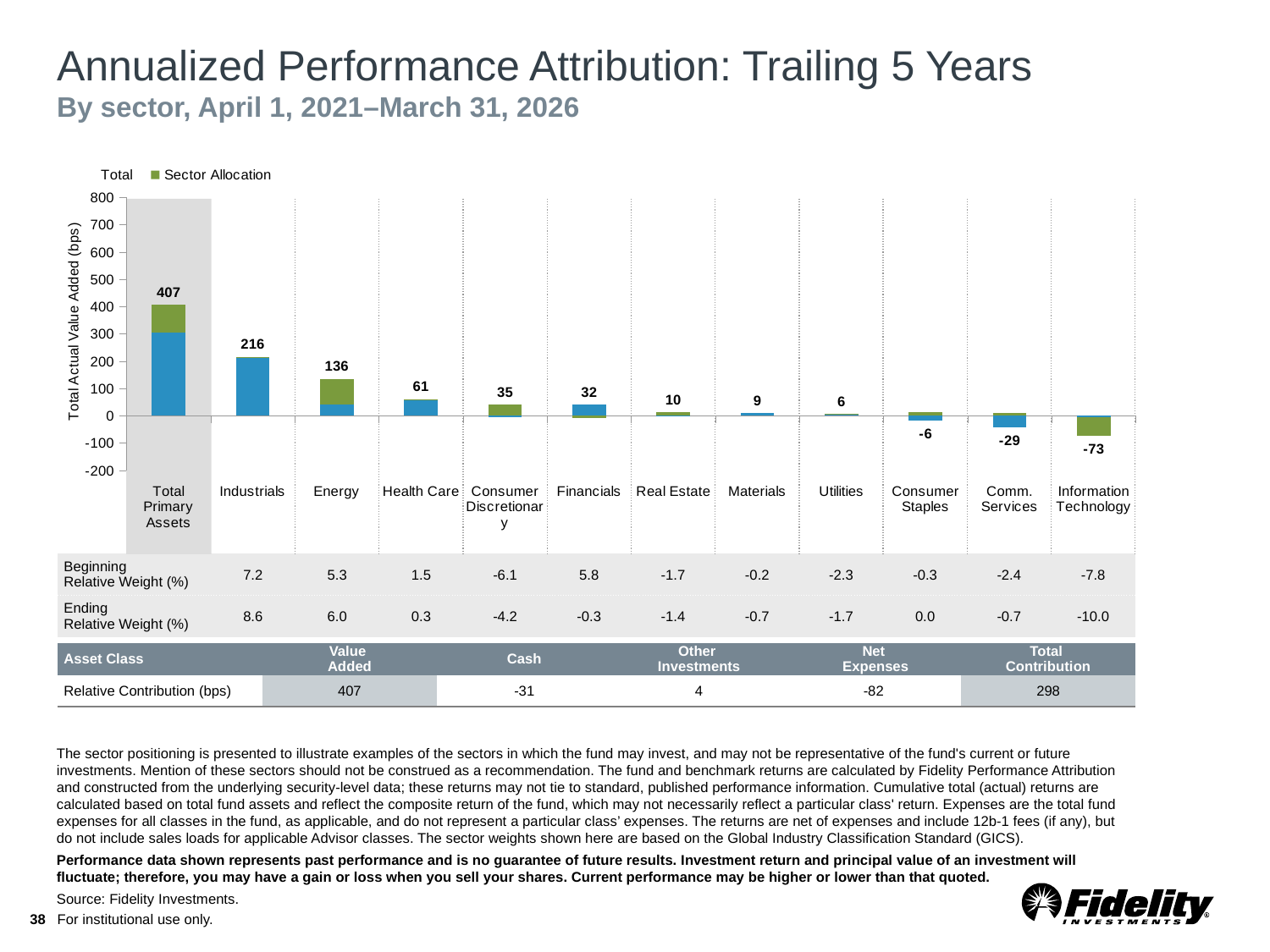
What is the labeled value for Total Primary Assets? 407 Which has a larger labeled value, Health Care or Financials? Health Care What is the label of the y axis of the chart? Total Actual Value Added (bps) What is the labeled value for Industrials? 216 What kind of chart is shown on the slide? Bar chart Which sector (excluding Total Primary Assets) has the highest labeled value? Industrials Which category has the lowest labeled value? Information Technology What is the labeled value for Information Technology? -73 How many categories are shown on the x axis of the chart? 12 How many series does the chart legend list? 2 Is the value for Total Primary Assets greater or less than 300? greater What is the difference between the labeled values for Industrials and Energy? 80